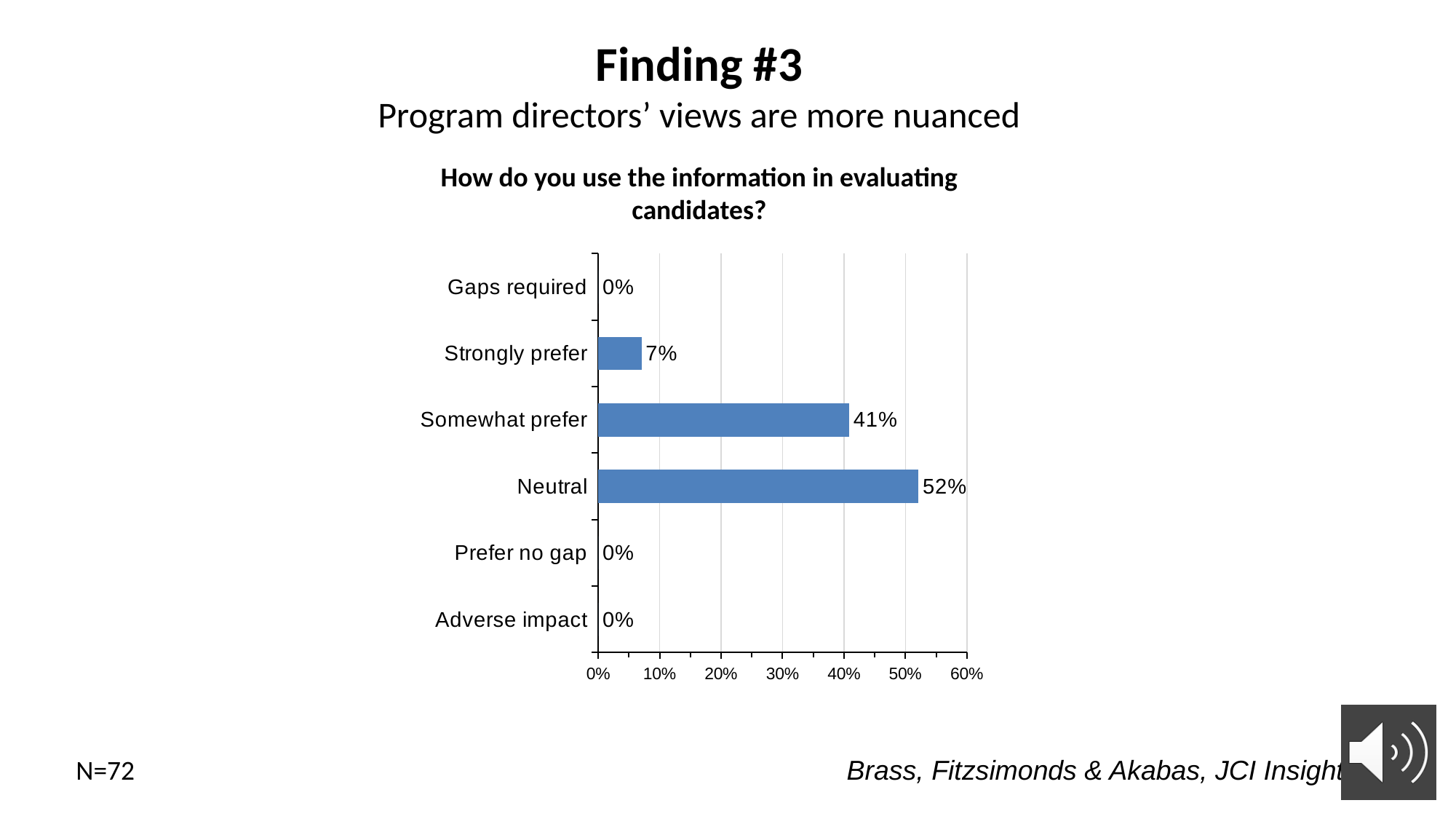
Is the value for Neutral greater or less than 50%? greater Which is larger, the value for Somewhat prefer or the value for Strongly prefer? Somewhat prefer What is the value for Gaps required? 0% What kind of chart is shown on the slide? bar chart What is the difference between the values for Neutral and Somewhat prefer? 11% How many categories are shown on the chart? 6 What is the value for Neutral? 52% What is the value for Somewhat prefer? 41% What is the difference between the values for Somewhat prefer and Strongly prefer? 34% Which category has the highest value? Neutral What is the title of the chart? How do you use the information in evaluating candidates? What is the value for Strongly prefer? 7%